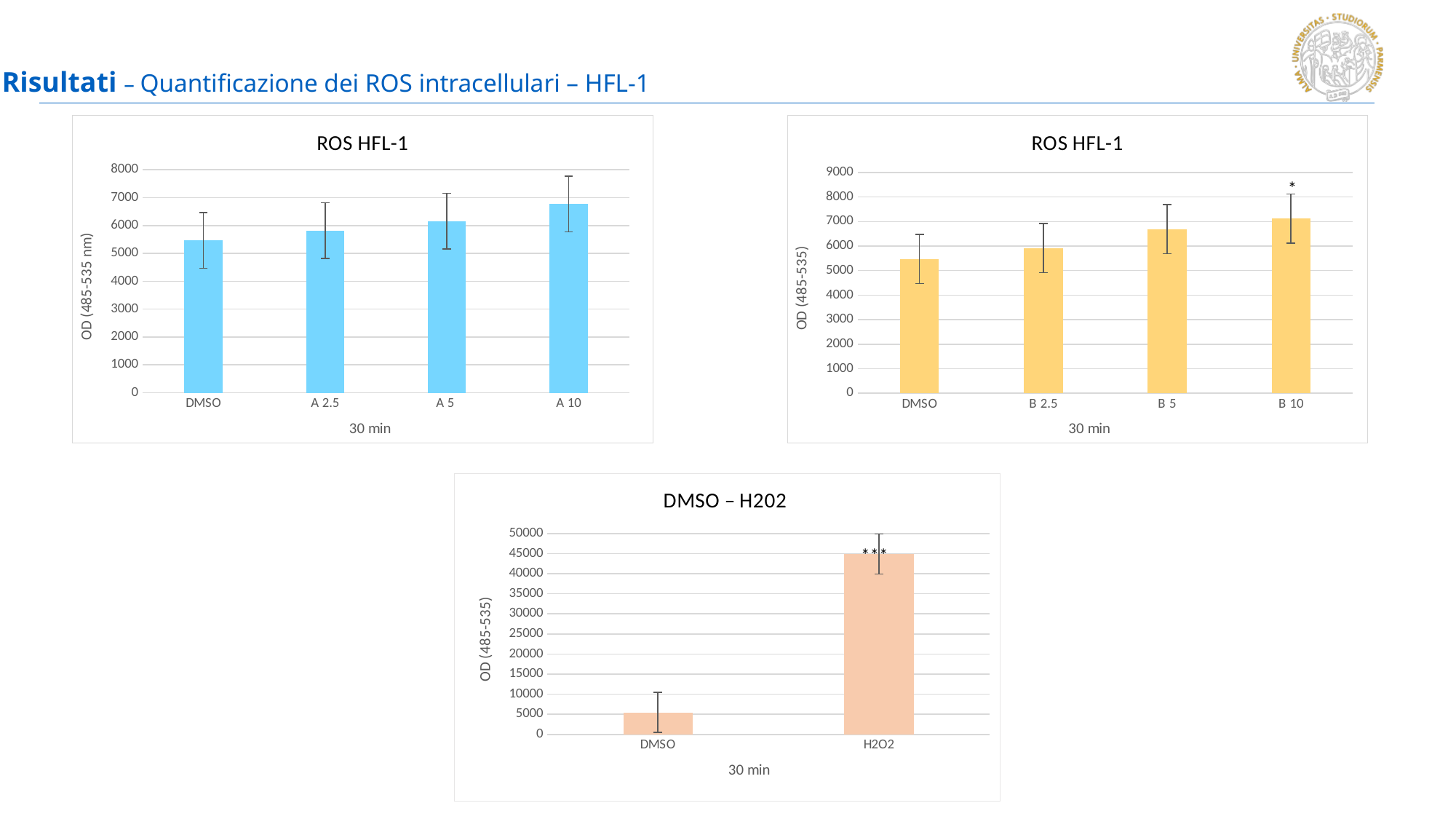
In the top-left ROS HFL-1 chart, is the value for A 10 greater or less than 6000? greater In the bottom DMSO – H202 chart, is the value for H2O2 greater or less than 40000? greater In the top-right ROS HFL-1 chart, which is larger, the value for DMSO or the value for B 10? B 10 What is the y-axis label of the top-left ROS HFL-1 chart? OD (485-535 nm) In the bottom DMSO – H202 chart, is the value for DMSO greater or less than 10000? less In the top-left ROS HFL-1 chart, which category has the highest bar? A 10 What kind of chart is the bottom DMSO – H202 chart? bar chart In the top-right ROS HFL-1 chart, which category has the highest bar? B 10 In the top-left ROS HFL-1 chart, do the bar values rise or fall from DMSO to A 10? rise In the top-left ROS HFL-1 chart, which category has the lowest bar? DMSO How many categories are shown in the top-left ROS HFL-1 chart? 4